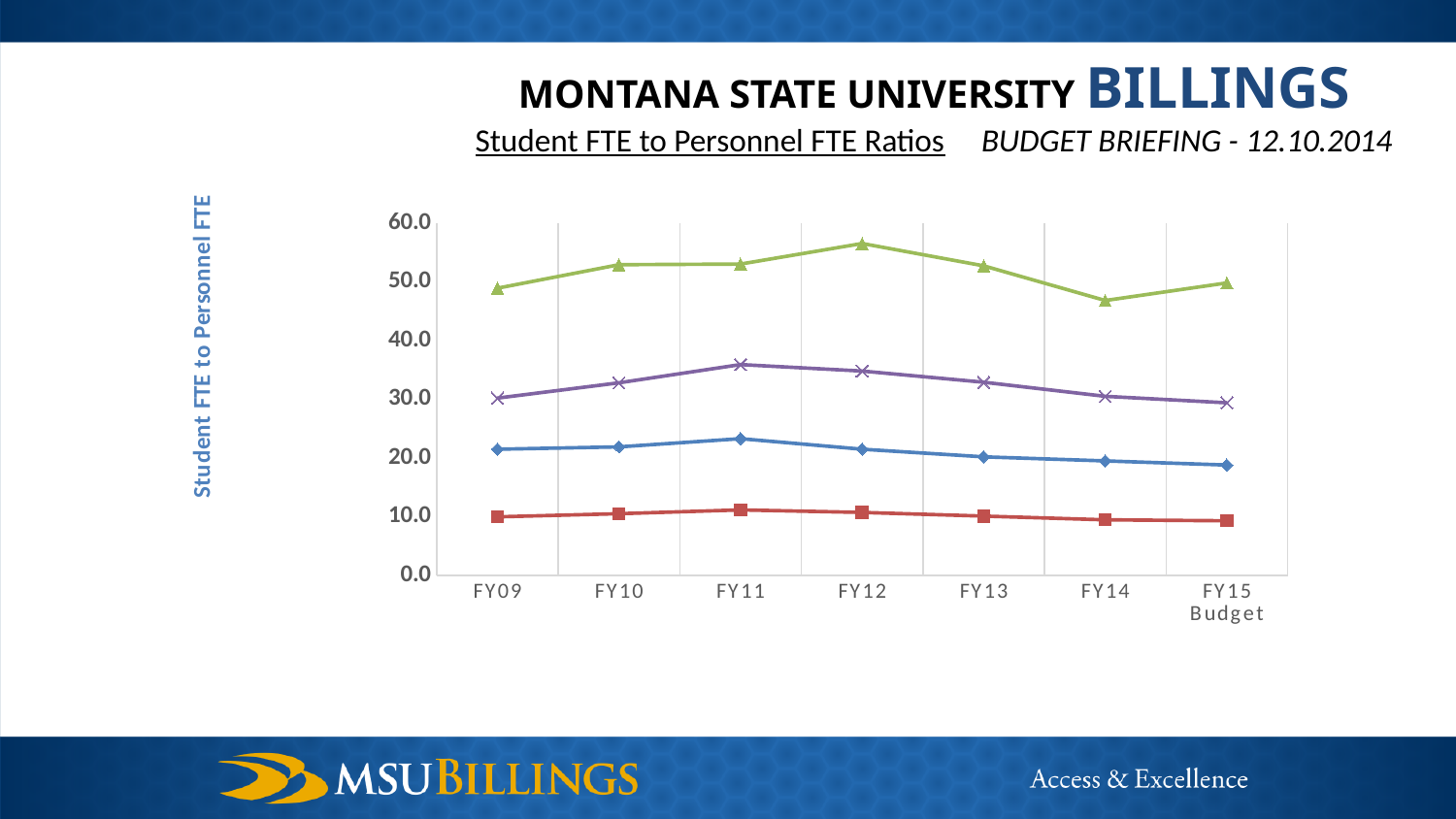
In which fiscal year does the green triangle line reach its highest value? FY12 Does the purple x-marker line rise or fall from FY11 to FY15 Budget? fall At FY09, which line has the larger value, the green triangle line or the purple x-marker line? green triangle line How many fiscal-year categories are shown on the x axis? 7 How many lines are plotted on the chart? 4 What is the title of the chart? Student FTE to Personnel FTE Ratios What kind of chart is shown on the slide? line chart What is the label on the vertical axis? Student FTE to Personnel FTE Is the value of the green triangle line for FY12 greater or less than 50.0? greater Is the value of the blue diamond line for FY15 Budget greater or less than 20.0? less In which fiscal year does the green triangle line reach its lowest value? FY14 In which fiscal year does the purple x-marker line reach its highest value? FY11